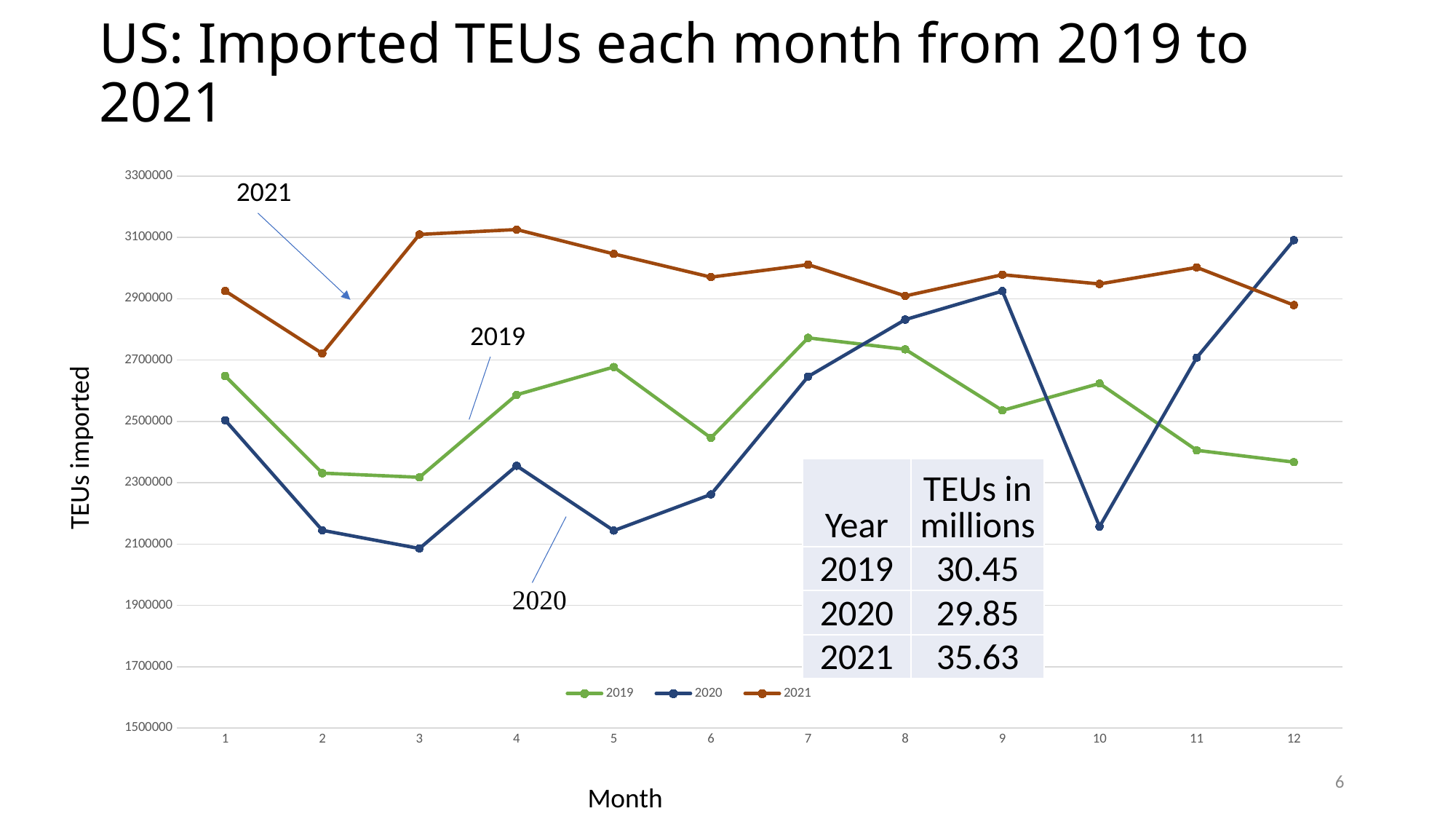
What kind of chart is shown on the slide? line chart In month 12, which series has the larger value, 2020 or 2021? 2020 In which month does the 2021 series reach its lowest value? 2 In which month does the 2019 series reach its highest value? 7 According to the table on the slide, how many TEUs in millions were imported in 2021? 35.63 Is the value for 2020 in month 10 greater or less than 2100000? greater How many months are plotted along the x axis? 12 How many series does the legend list? 3 In which month does the 2020 series reach its highest value? 12 In month 10, which series has the larger value, 2019 or 2020? 2019 Is the value for 2019 in month 6 greater or less than 2500000? less